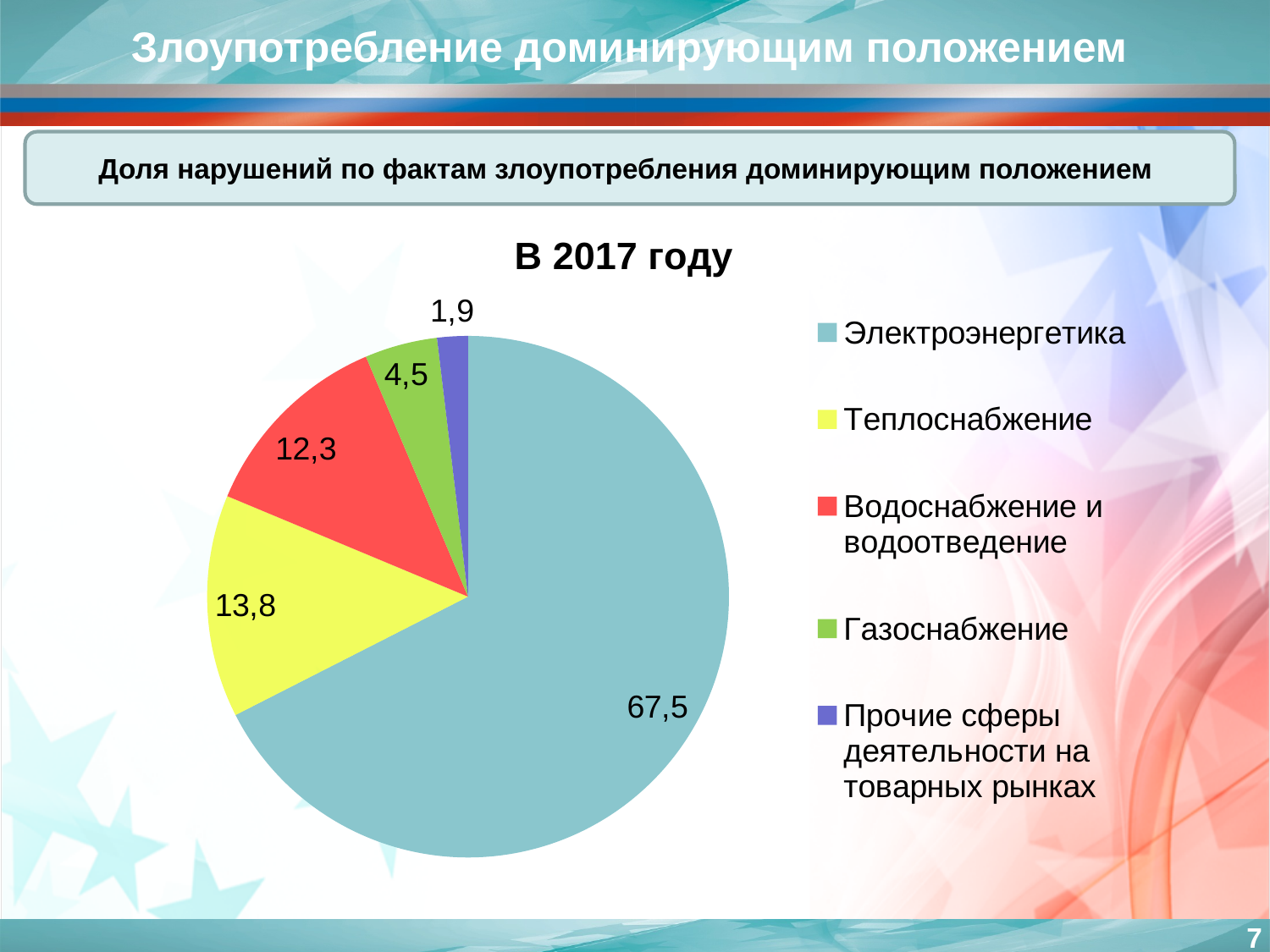
What is the value for Электроэнергетика? 67,5 Which is larger, the value for Газоснабжение or the value for Прочие сферы деятельности на товарных рынках? Газоснабжение What is the title of the pie chart? В 2017 году What is the value for Водоснабжение и водоотведение? 12,3 Which category has the largest slice of the pie? Электроэнергетика What is the difference between the values for Электроэнергетика and Теплоснабжение? 53,7 How many slices does the pie chart have? 5 Which category has the smallest slice of the pie? Прочие сферы деятельности на товарных рынках What kind of chart is shown on the slide? pie chart What is the value for Газоснабжение? 4,5 What is the value for Теплоснабжение? 13,8 What is the value for Прочие сферы деятельности на товарных рынках? 1,9